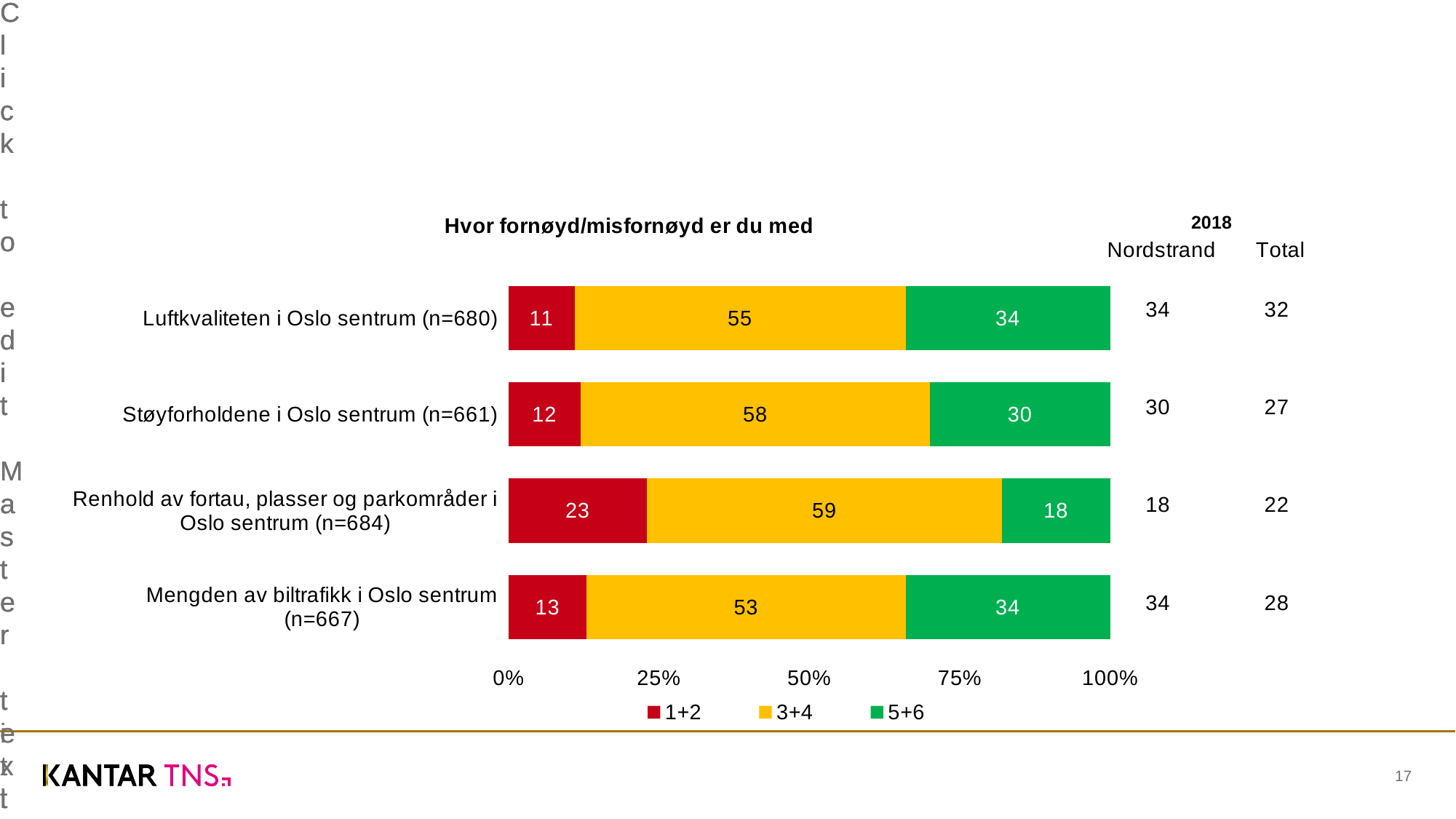
How many categories are plotted in the chart? 4 What is the value of the 1+2 segment for "Renhold av fortau, plasser og parkområder i Oslo sentrum (n=684)"? 23 What is the title of the chart? Hvor fornøyd/misfornøyd er du med What kind of chart is shown on the slide? Stacked bar chart What is the value of the 5+6 segment for "Mengden av biltrafikk i Oslo sentrum (n=667)"? 34 Which category has the highest 1+2 value? Renhold av fortau, plasser og parkområder i Oslo sentrum (n=684) What is the value of the 3+4 segment for "Støyforholdene i Oslo sentrum (n=661)"? 58 What is the total of the stacked bar for "Luftkvaliteten i Oslo sentrum (n=680)"? 100 Which category has the lowest 5+6 value? Renhold av fortau, plasser og parkområder i Oslo sentrum (n=684) What is the difference between the 3+4 values for "Renhold av fortau, plasser og parkområder i Oslo sentrum (n=684)" and "Mengden av biltrafikk i Oslo sentrum (n=667)"? 6 Which is larger: the 5+6 value for "Luftkvaliteten i Oslo sentrum (n=680)" or for "Støyforholdene i Oslo sentrum (n=661)"? Luftkvaliteten i Oslo sentrum (n=680) How many series does the legend list? 3